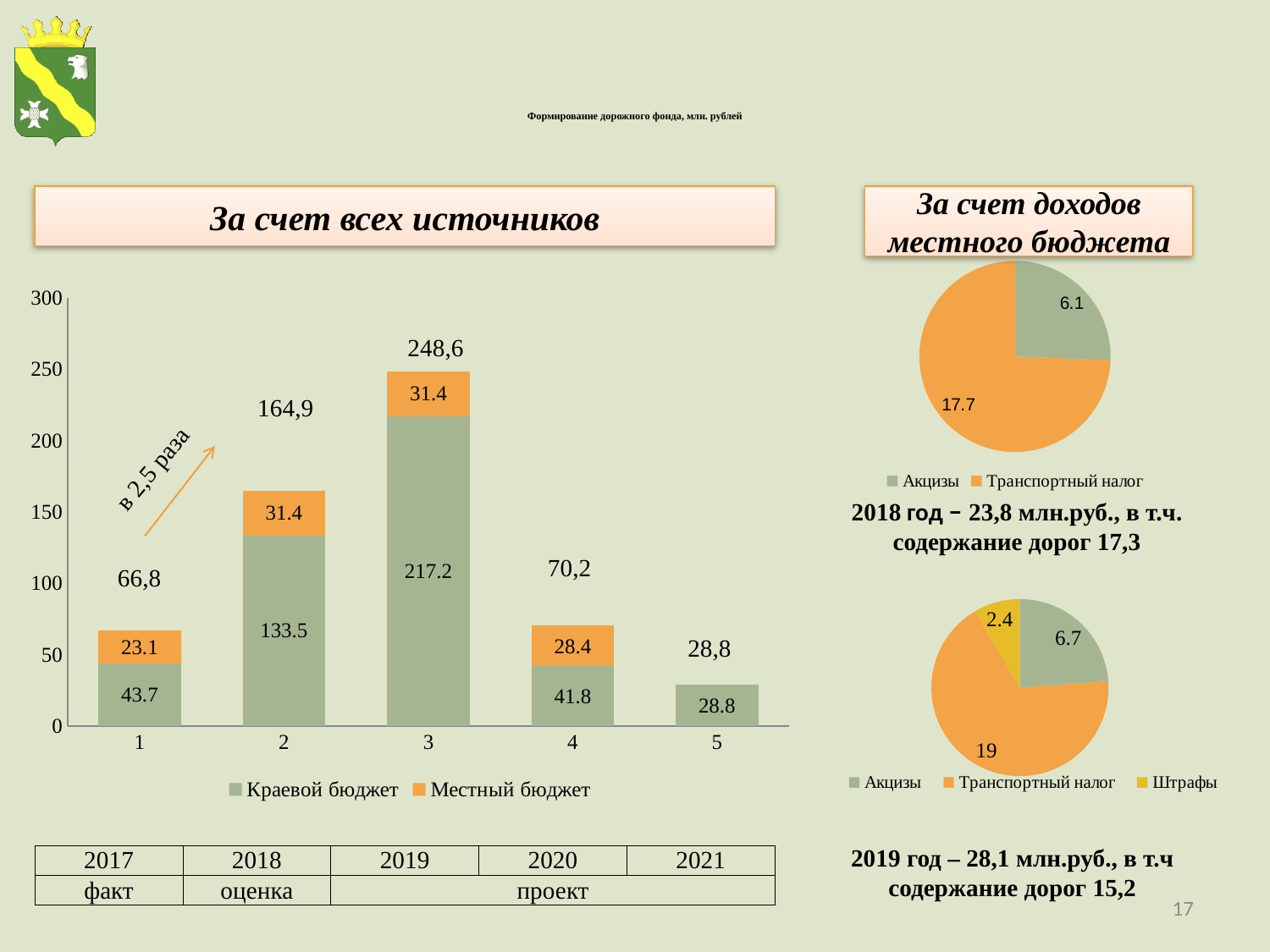
What kind of chart is 'За счет всех источников'? bar chart In the lower pie chart (2019) under 'За счет доходов местного бюджета', what is the value for Штрафы? 2.4 In the bar chart 'За счет всех источников', which category has the lowest total? 5 How many slices does the lower pie chart (2019) under 'За счет доходов местного бюджета' have? 3 In the upper pie chart (2018) under 'За счет доходов местного бюджета', what is the value for Транспортный налог? 17.7 In the bar chart 'За счет всех источников', which category has the larger Местный бюджет value, category 2 or category 4? 2 In the bar chart 'За счет всех источников', what is the total of the stacked bar for category 2? 164,9 In the bar chart 'За счет всех источников', what is the difference between the Краевой бюджет values for category 2 and category 1? 89.8 In the bar chart 'За счет всех источников', what is the value of Краевой бюджет for category 3? 217.2 How many series does the legend of the bar chart 'За счет всех источников' list? 2 In the bar chart 'За счет всех источников', which category has the highest total? 3 In the bar chart 'За счет всех источников', what is the value of Местный бюджет for category 1? 23.1